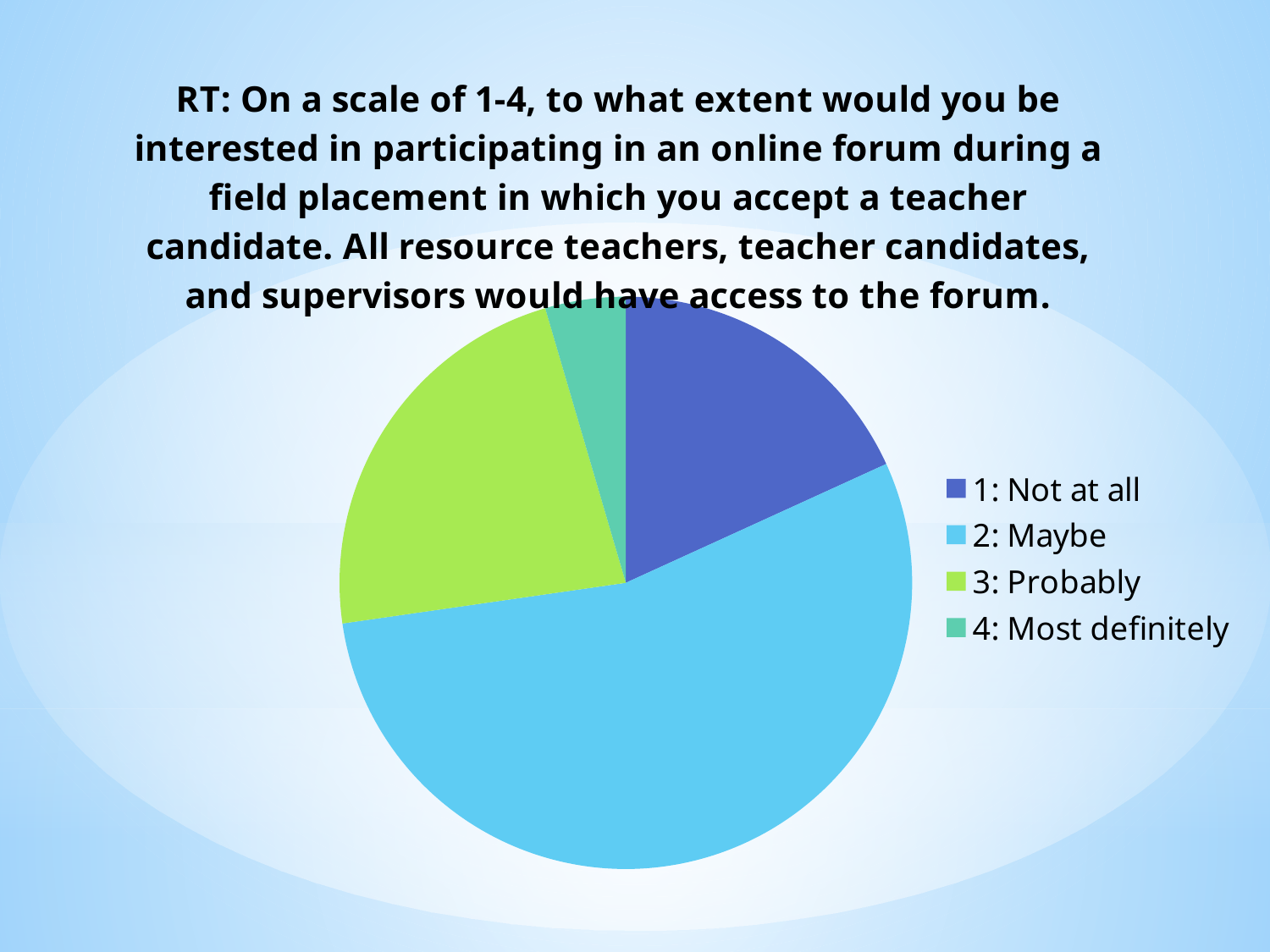
How many entries does the legend list? 4 What colour is the "3: Probably" slice in the pie chart? green Which slice is larger, "3: Probably" or "4: Most definitely"? 3: Probably Which slice is larger, "2: Maybe" or "3: Probably"? 2: Maybe Which slice is larger, "2: Maybe" or "1: Not at all"? 2: Maybe Does the "2: Maybe" slice make up more or less than half of the pie? more Which response category has the smallest slice of the pie? 4: Most definitely Which response category has the largest slice of the pie? 2: Maybe How many slices does the pie chart have? 4 Which legend entry is shown in dark blue? 1: Not at all What kind of chart is shown on the slide? pie chart